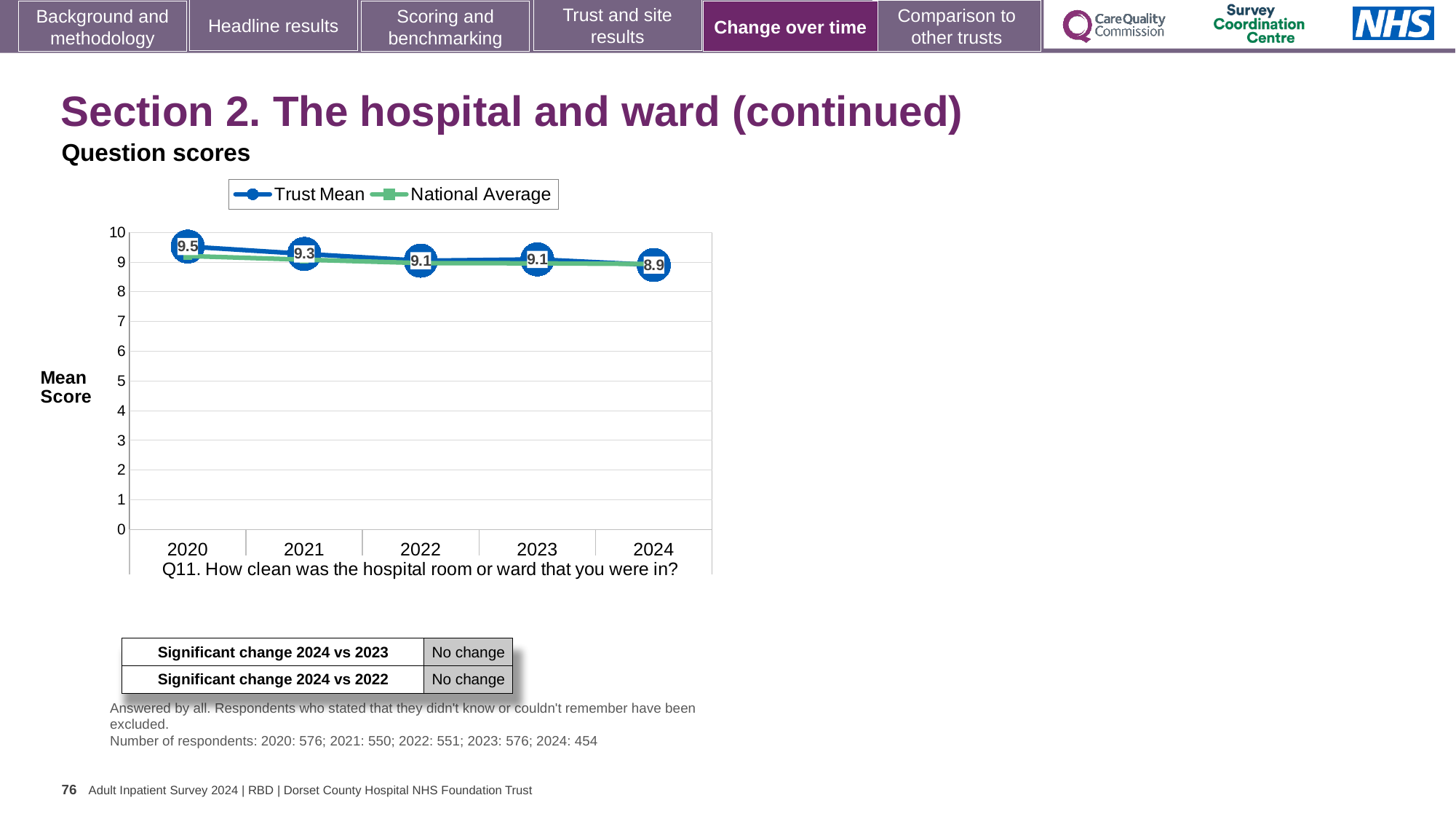
What is the Trust Mean value for 2024? 8.9 In which year is the Trust Mean lowest? 2024 How many years are plotted on the x axis? 5 What is the Trust Mean value for 2022? 9.1 What kind of chart is shown on the slide? Line chart What is the Trust Mean value for 2020? 9.5 Which is larger, the Trust Mean in 2021 or in 2023? 2021 Is the National Average value for 2020 greater or less than 8? greater How many series does the legend list? 2 In which year is the Trust Mean highest? 2020 What is the difference between the Trust Mean in 2020 and in 2024? 0.6 Does the Trust Mean rise or fall from 2020 to 2024? Fall